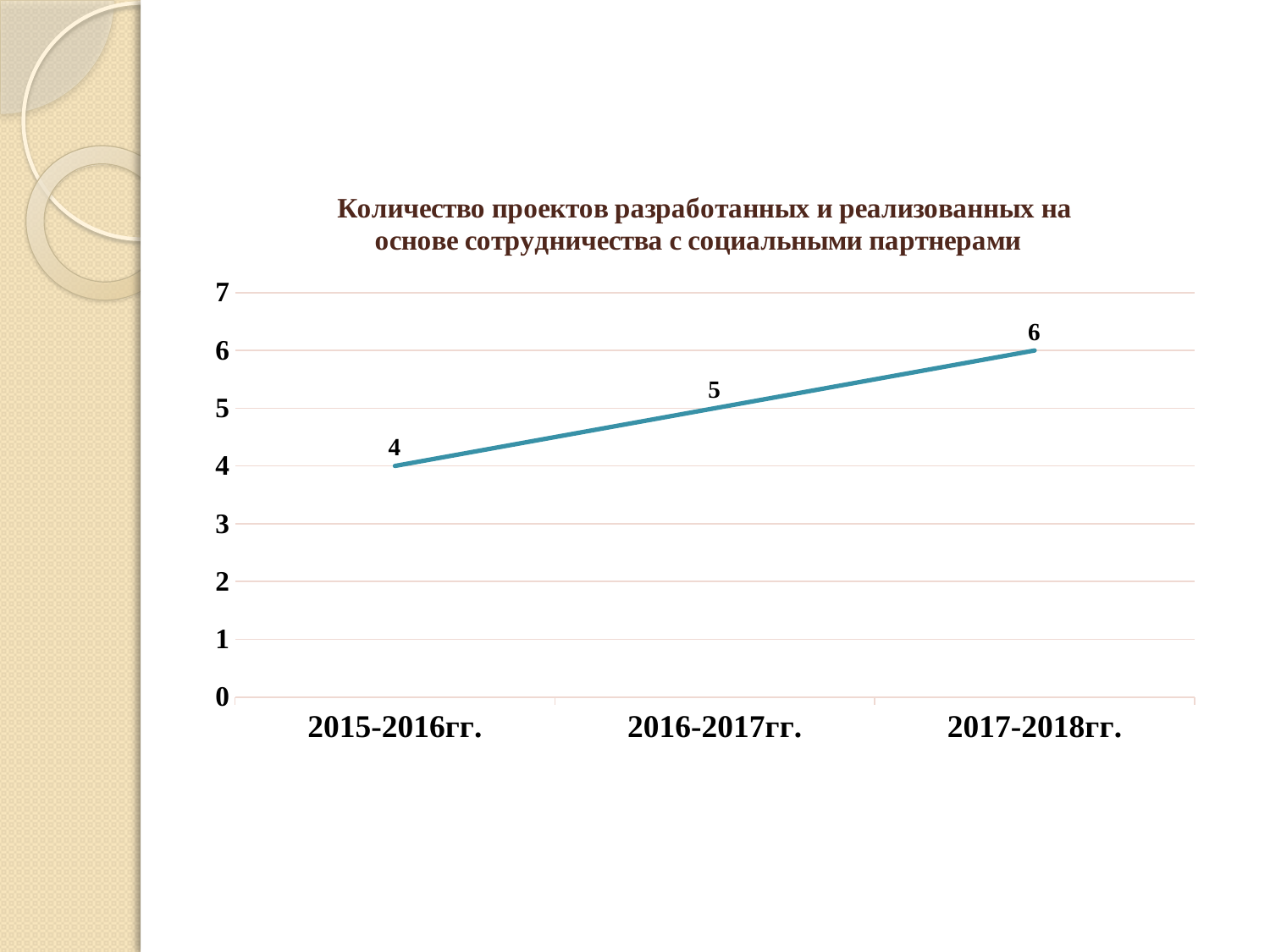
How many periods are shown on the x axis? 3 Which period has the lowest value? 2015-2016гг. What is the value for 2016-2017гг.? 5 Which is larger, the value for 2016-2017гг. or the value for 2015-2016гг.? 2016-2017гг. What kind of chart is shown on the slide? line chart What is the difference between the values for 2017-2018гг. and 2015-2016гг.? 2 What is the value for 2017-2018гг.? 6 What is the value for 2015-2016гг.? 4 Which period has the highest value? 2017-2018гг. Do the values rise or fall from 2015-2016гг. to 2017-2018гг.? rise Is the value for 2017-2018гг. greater or less than 5? greater What is the highest value shown on the vertical axis? 7